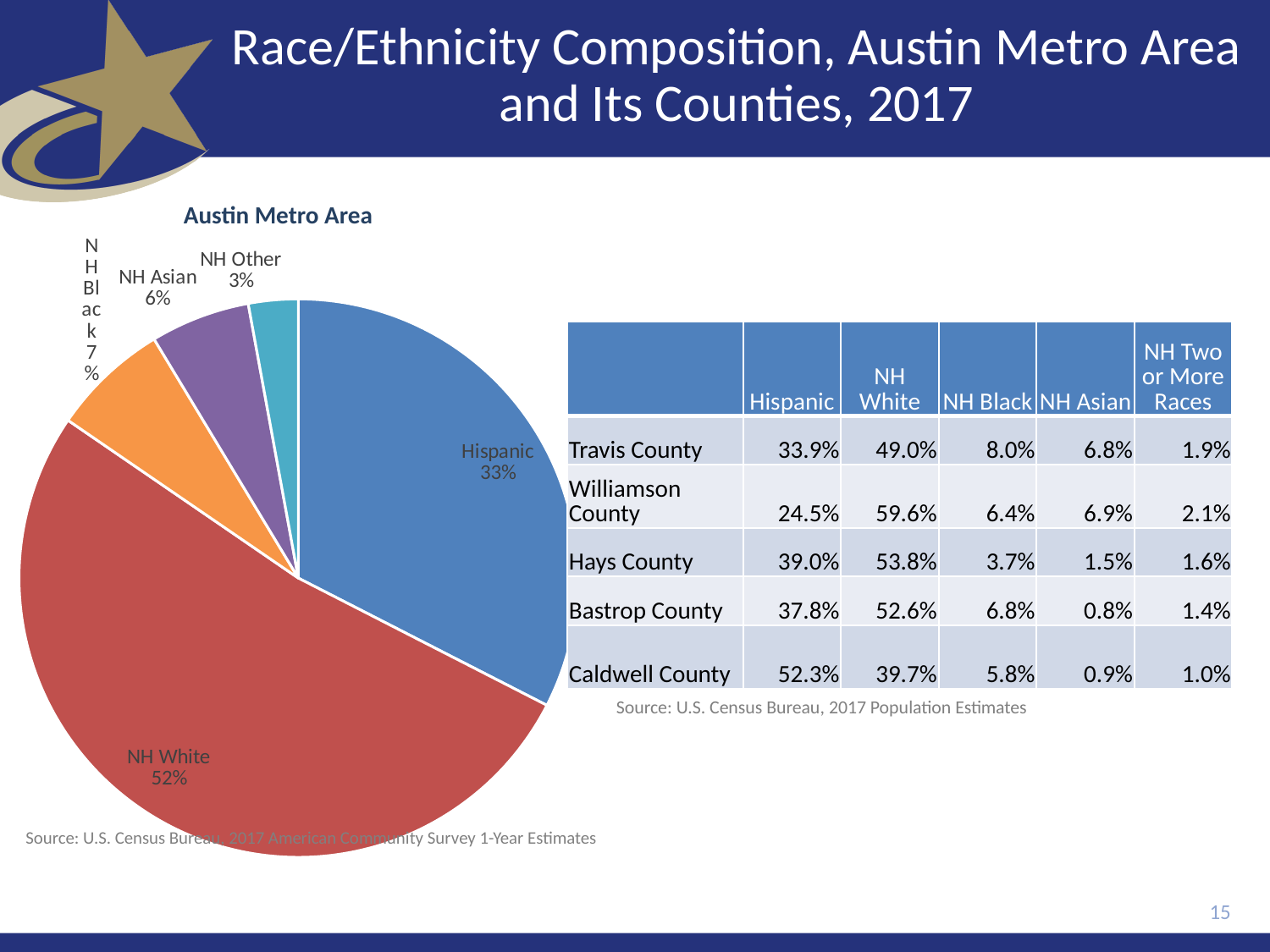
Which slice of the Austin Metro Area pie chart is the largest? NH White In the Austin Metro Area pie chart, which is larger, NH Black or NH Asian? NH Black What share of the Austin Metro Area pie is NH Asian? 6% What is the title of the pie chart on the slide? Austin Metro Area What share of the Austin Metro Area pie is NH Other? 3% What share of the Austin Metro Area pie is NH White? 52% In the Austin Metro Area pie chart, what is the difference between the NH White share and the Hispanic share? 19% How many slices does the Austin Metro Area pie chart have? 5 What kind of chart is the Austin Metro Area chart? Pie chart Which slice of the Austin Metro Area pie chart is the smallest? NH Other